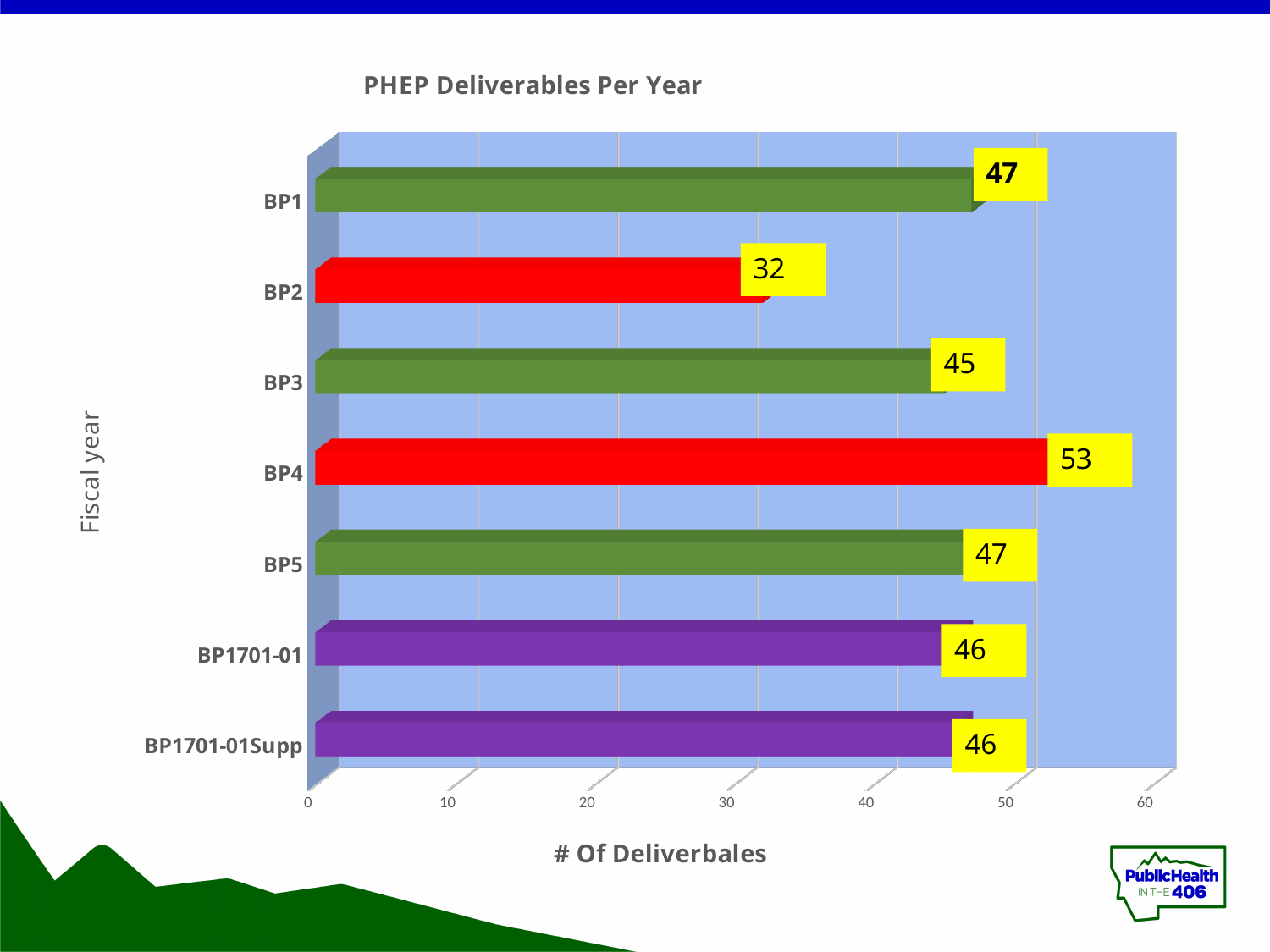
What is the number of deliverables for BP4? 53 Is the value for BP2 greater or less than 40? less What is the difference in deliverables between BP1 and BP3? 2 What kind of chart is shown on the slide? bar chart How many fiscal years are shown in the chart? 7 Which fiscal year has the lowest number of deliverables? BP2 What is the number of deliverables for BP1701-01Supp? 46 Which fiscal year has the highest number of deliverables? BP4 Which has more deliverables, BP3 or BP5? BP5 What is the difference in deliverables between BP4 and BP2? 21 What is the title of the chart? PHEP Deliverables Per Year What is the number of deliverables for BP2? 32